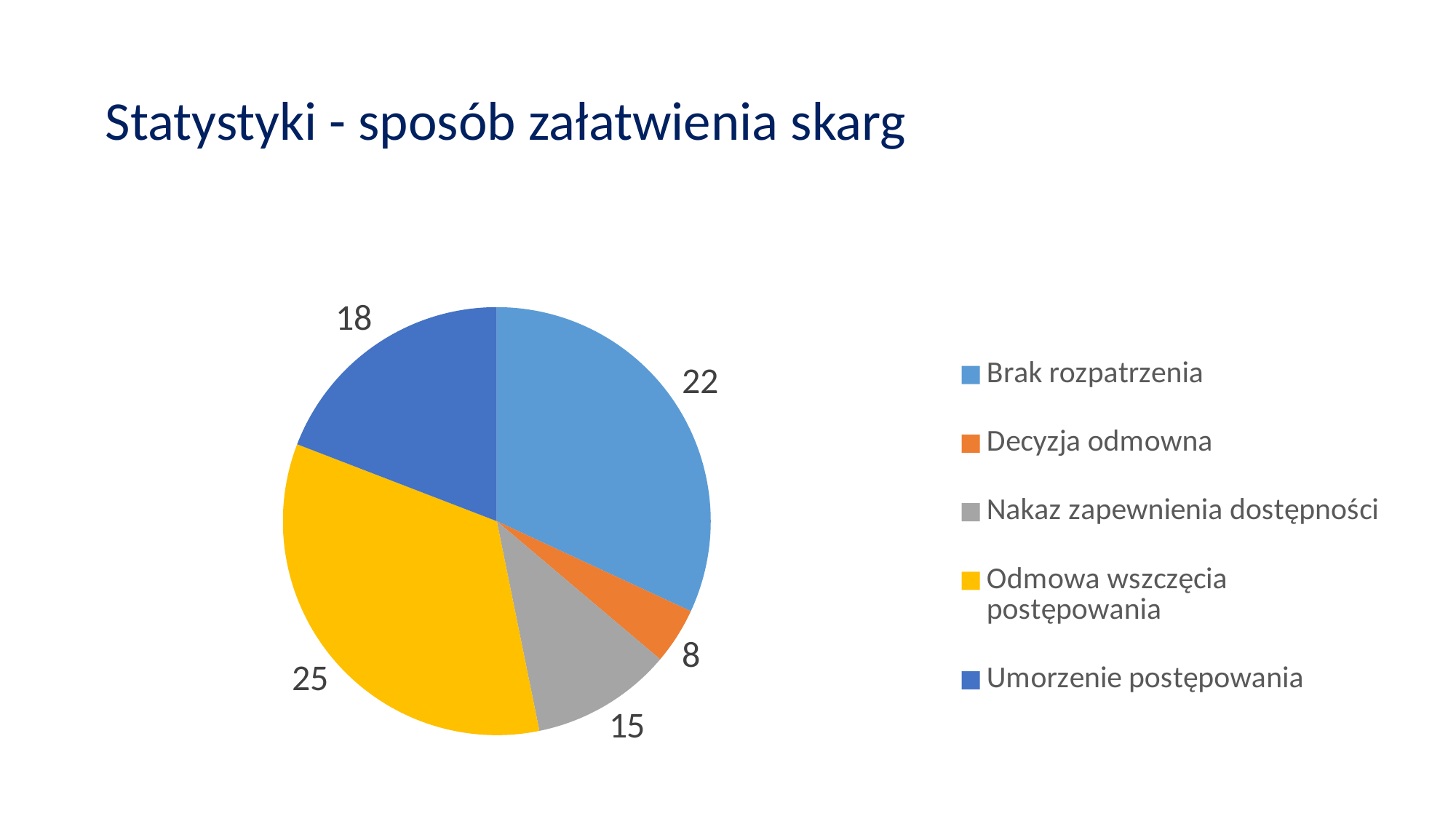
What is the value for Brak rozpatrzenia? 22 How many categories does the pie chart show? 5 What is the value for Decyzja odmowna? 8 Which is larger, Brak rozpatrzenia or Nakaz zapewnienia dostępności? Brak rozpatrzenia What is the value for Nakaz zapewnienia dostępności? 15 What is the value for Umorzenie postępowania? 18 Which category has the smallest slice? Decyzja odmowna What kind of chart is shown on the slide? Pie chart What is the difference between the values for Odmowa wszczęcia postępowania and Umorzenie postępowania? 7 Which category has the largest slice? Odmowa wszczęcia postępowania What is the value for Odmowa wszczęcia postępowania? 25